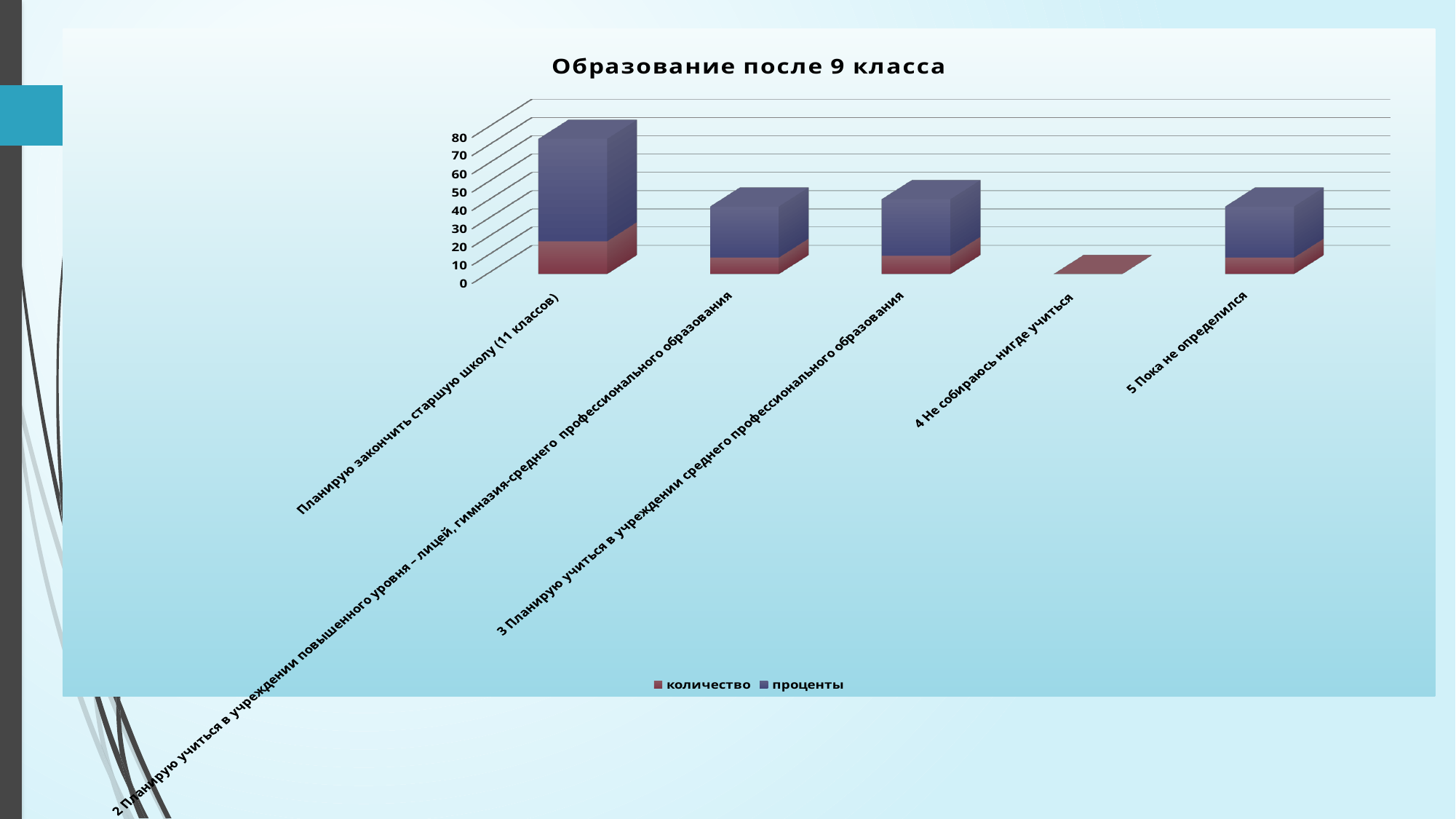
Which stacked bar is taller: 'Планирую закончить старшую школу (11 классов)' or '5 Пока не определился'? Планирую закончить старшую школу (11 классов) Which category has the shortest stacked bar? 4 Не собираюсь нигде учиться What is the title of the chart? Образование после 9 класса Which series is shown in red in the legend? количество Is the total stacked value for '4 Не собираюсь нигде учиться' greater or less than 10? less What kind of chart is shown on the slide? bar chart Is the total stacked value for '5 Пока не определился' greater or less than 60? less Is the total stacked value for 'Планирую закончить старшую школу (11 классов)' greater or less than 50? greater How many categories are shown on the x axis? 5 How many series does the legend list? 2 Which category has the tallest stacked bar? Планирую закончить старшую школу (11 классов)